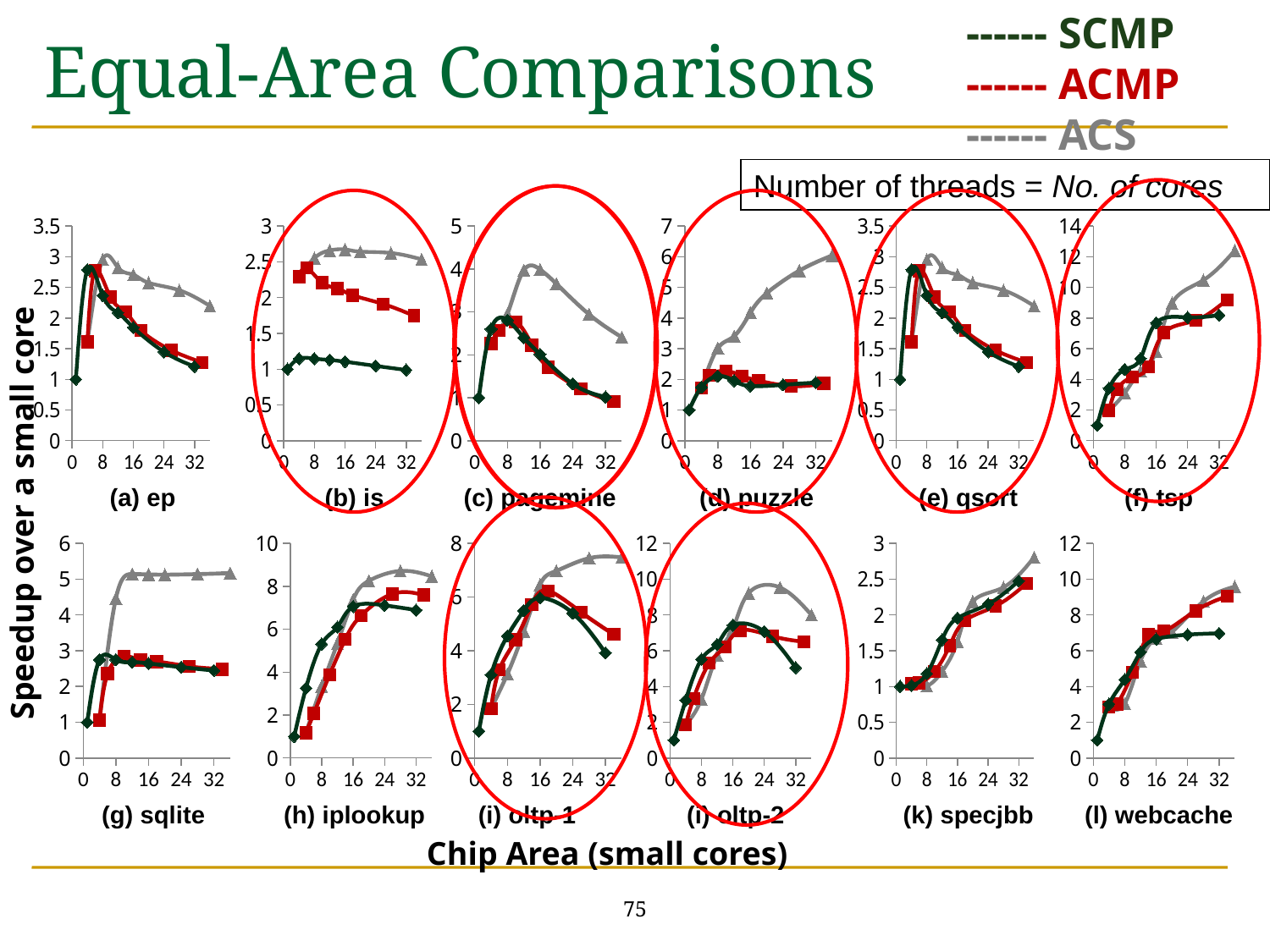
In chart (h) iplookup, does the SCMP line rise or fall as chip area increases from 0 to 16? rise How many benchmark panels (charts) are shown on the slide? 12 How many series does the legend at the top right list? 3 In chart (g) sqlite, is the ACS value at chip area 32 greater or less than 4? greater In chart (f) tsp, which series has the highest speedup at chip area 32? ACS In chart (a) ep, does the ACS line rise or fall as chip area increases from 8 to 32? fall In chart (b) is, at chip area 8, which series is larger: ACMP or SCMP? ACMP What is the label of the shared x axis for all the charts? Chip Area (small cores) In chart (b) is, is the SCMP value at chip area 32 greater or less than 1.5? less In chart (c) pagemine, which series has the highest speedup at chip area 16? ACS In chart (d) puzzle, is the ACS value at chip area 32 greater or less than 5? greater What kind of chart is used for the twelve panels on this slide? line chart